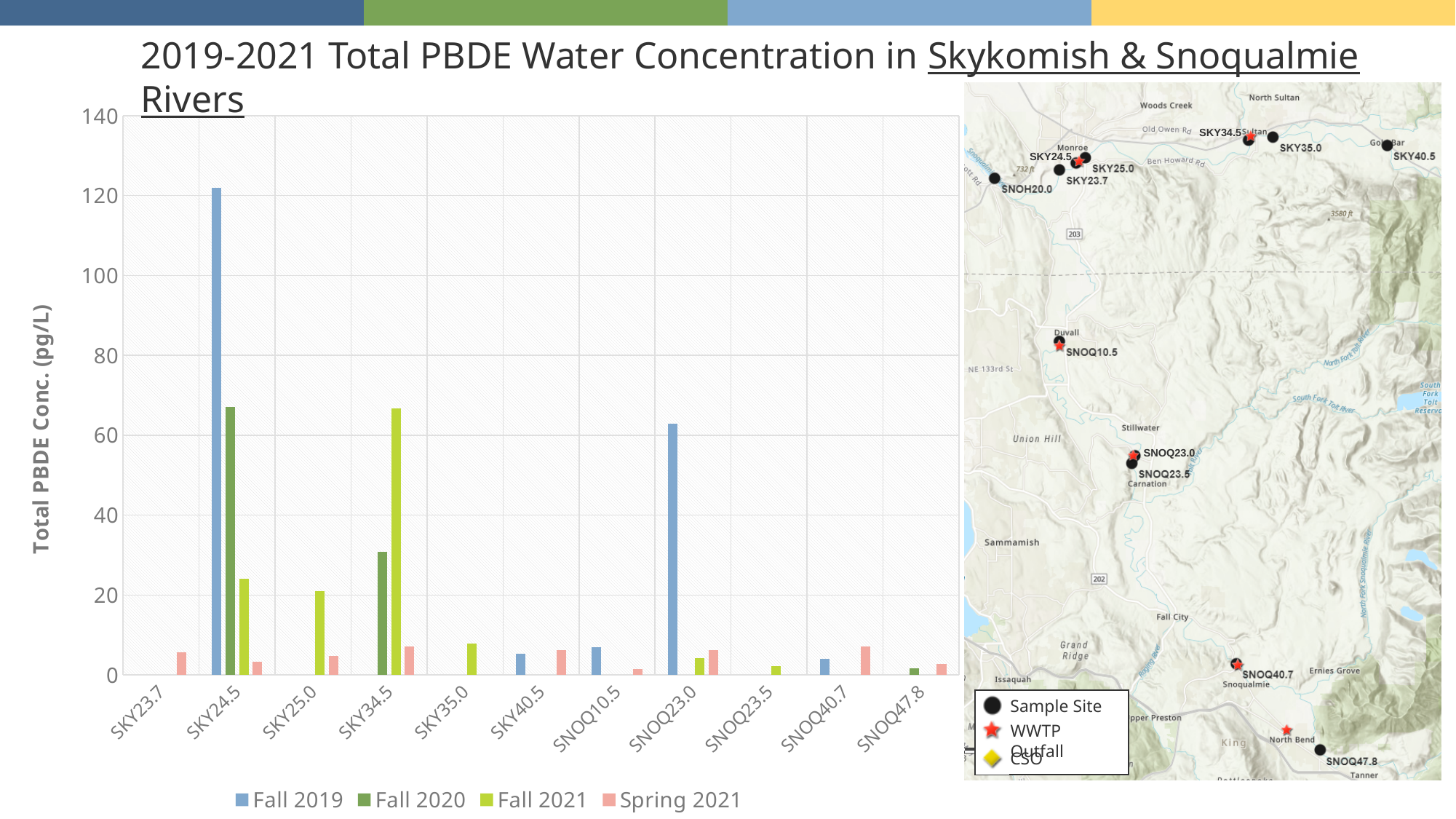
What is the label of the chart's y axis? Total PBDE Conc. (pg/L) How many series does the chart legend list? 4 What kind of chart is shown on the slide? Bar chart Is the Fall 2019 value for SKY24.5 greater or less than 100? greater Which site has the highest Fall 2021 Total PBDE concentration? SKY34.5 Is the Fall 2020 value for SKY24.5 greater or less than 60? greater How many sampling sites are shown along the x axis of the chart? 11 At SKY34.5, which is larger: the Fall 2020 value or the Fall 2021 value? Fall 2021 At SKY24.5, which is larger: the Fall 2020 value or the Fall 2021 value? Fall 2020 Which site has the highest Fall 2019 Total PBDE concentration? SKY24.5 Is the Fall 2019 value for SNOQ23.0 greater or less than 40? greater